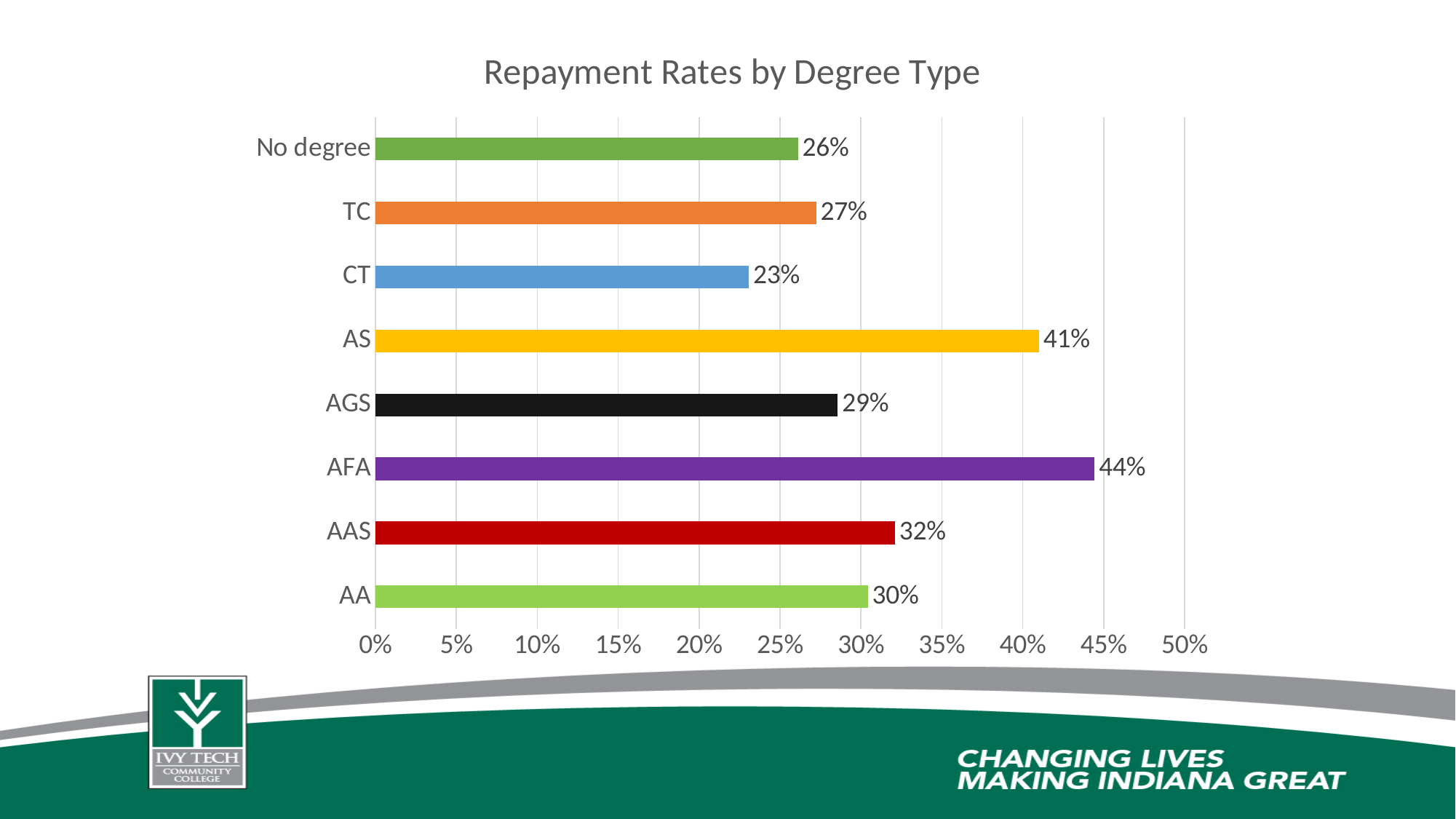
What is the title of the chart? Repayment Rates by Degree Type Which has a higher repayment rate, AA or TC? AA What kind of chart is shown on the slide? Bar chart What is the repayment rate for No degree? 26% What is the repayment rate for AFA? 44% Is the repayment rate for AS greater or less than 35%? greater Which degree type has the highest repayment rate? AFA How many degree types are shown in the chart? 8 What is the difference between the repayment rates for AS and AAS? 9% What colour is the bar for AFA? Purple Which degree type has the lowest repayment rate? CT What is the repayment rate for AGS? 29%